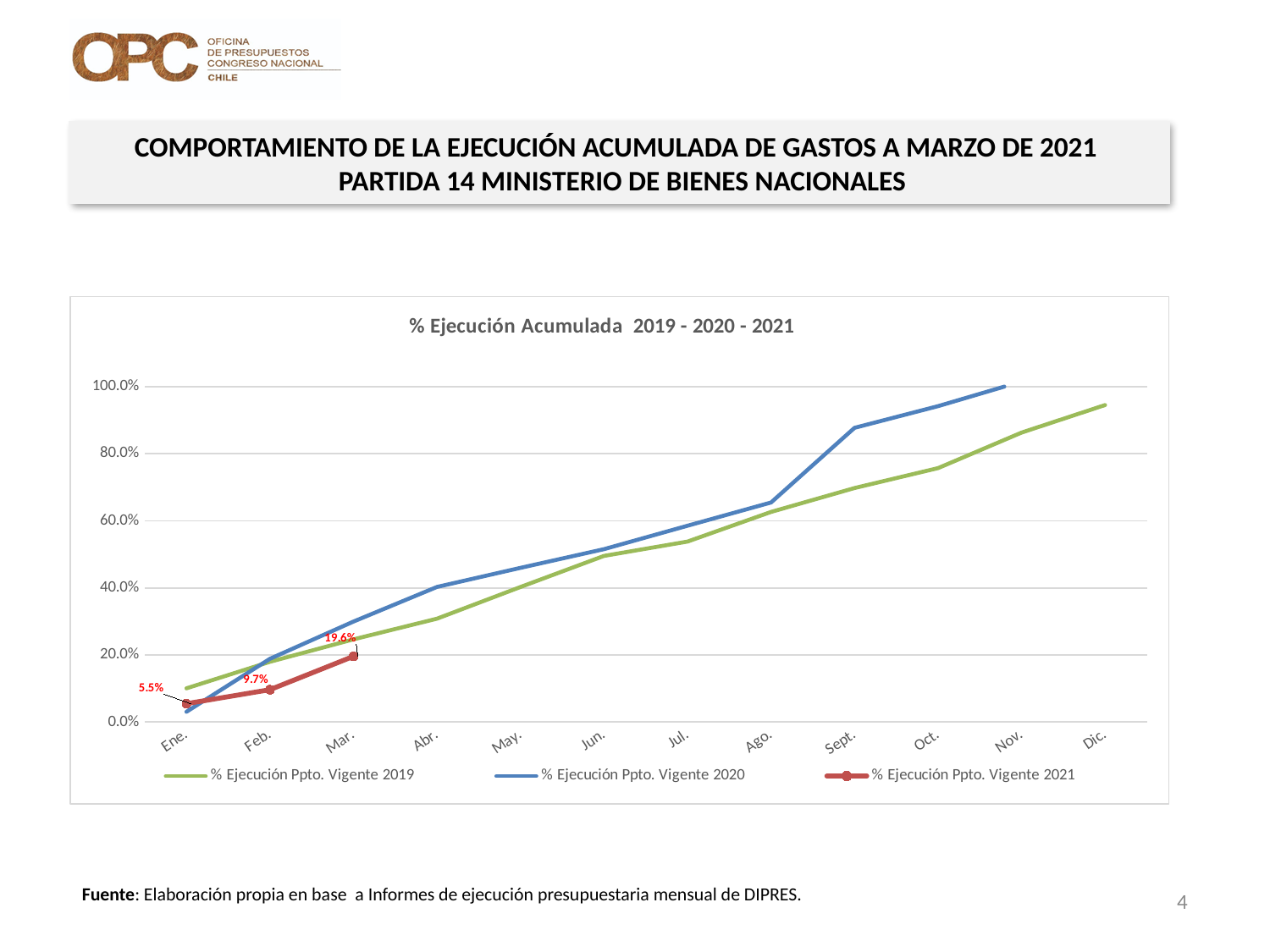
What is the value of % Ejecución Ppto. Vigente 2021 in Ene.? 5.5% What is the value of % Ejecución Ppto. Vigente 2021 in Mar.? 19.6% How many months are shown on the x axis? 12 In Sept., which series is higher: % Ejecución Ppto. Vigente 2019 or % Ejecución Ppto. Vigente 2020? % Ejecución Ppto. Vigente 2020 What is the value of % Ejecución Ppto. Vigente 2021 in Feb.? 9.7% What is the difference between the Mar. and Feb. values of % Ejecución Ppto. Vigente 2021? 9.9 percentage points What kind of chart is shown on the slide? Line chart Is the value for % Ejecución Ppto. Vigente 2019 in Dic. greater or less than 80%? greater Does the % Ejecución Ppto. Vigente 2020 line rise or fall from Ene. to Nov.? Rise What is the title of the chart? % Ejecución Acumulada 2019 - 2020 - 2021 How many series does the legend list? 3